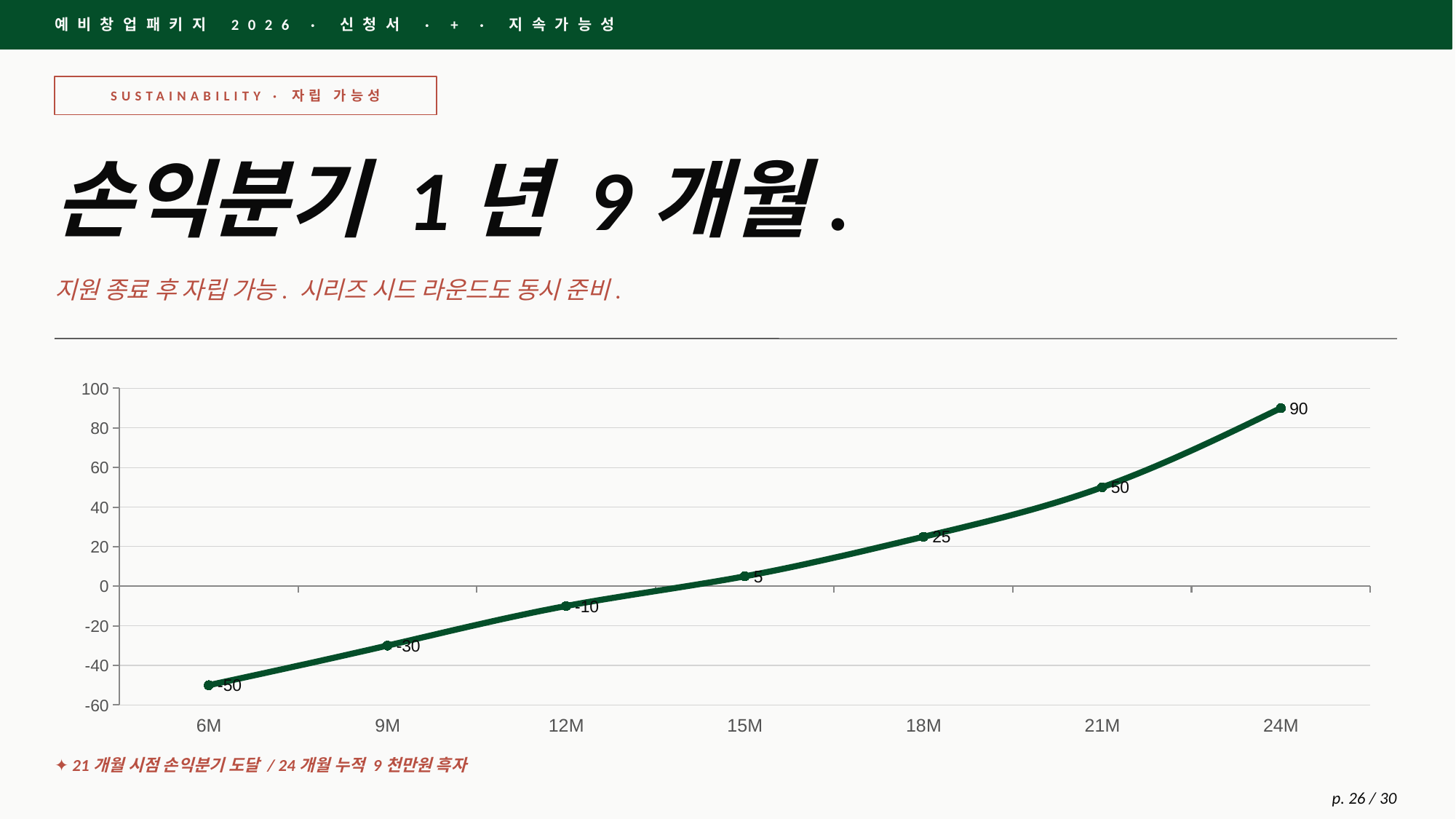
What is the value at 15M? 5 Which point on the x axis has the lowest value? 6M What is the difference between the values at 24M and 21M? 40 What kind of chart is shown on the slide? line chart How many data points are plotted on the chart? 7 Which point on the x axis has the highest value? 24M What is the value at 18M? 25 What is the difference between the values at 12M and 9M? 20 What is the value at 24M? 90 What is the value at 6M? -50 Do the values rise or fall from 6M to 24M? rise Which is larger, the value at 18M or the value at 15M? 18M